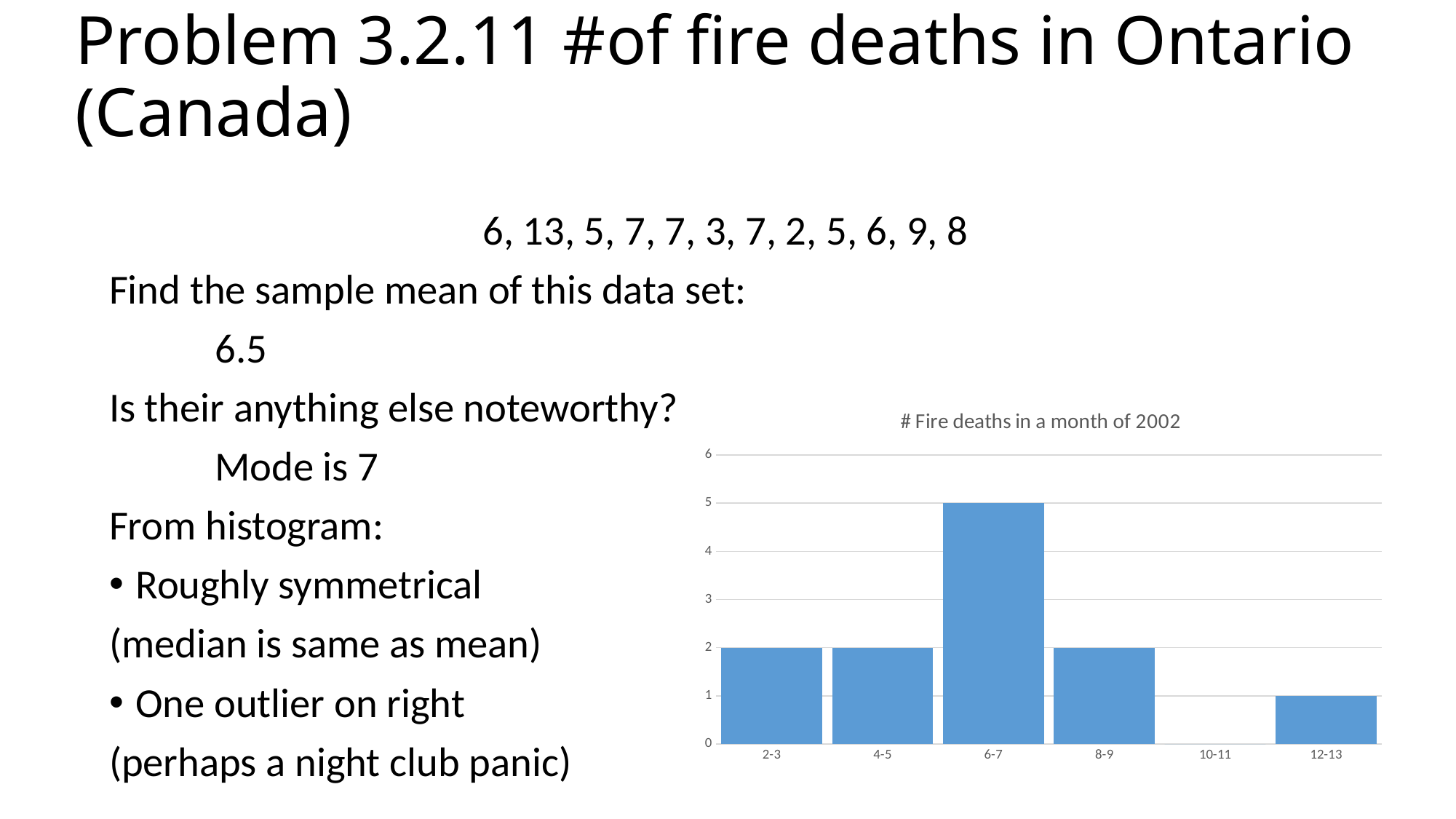
Which category has the highest value? 6-7 What is the title of the chart? # Fire deaths in a month of 2002 What is the value for the 6-7 category? 5 How many categories are shown on the x axis of the chart? 6 What is the difference between the values for 6-7 and 8-9? 3 What kind of chart is shown on the slide? bar chart Is the value for 6-7 greater or less than 4? greater What is the value for the 10-11 category? 0 What is the value for the 2-3 category? 2 Which category has the lowest value? 10-11 Which is larger, the value for 4-5 or the value for 12-13? 4-5 What is the value for the 12-13 category? 1